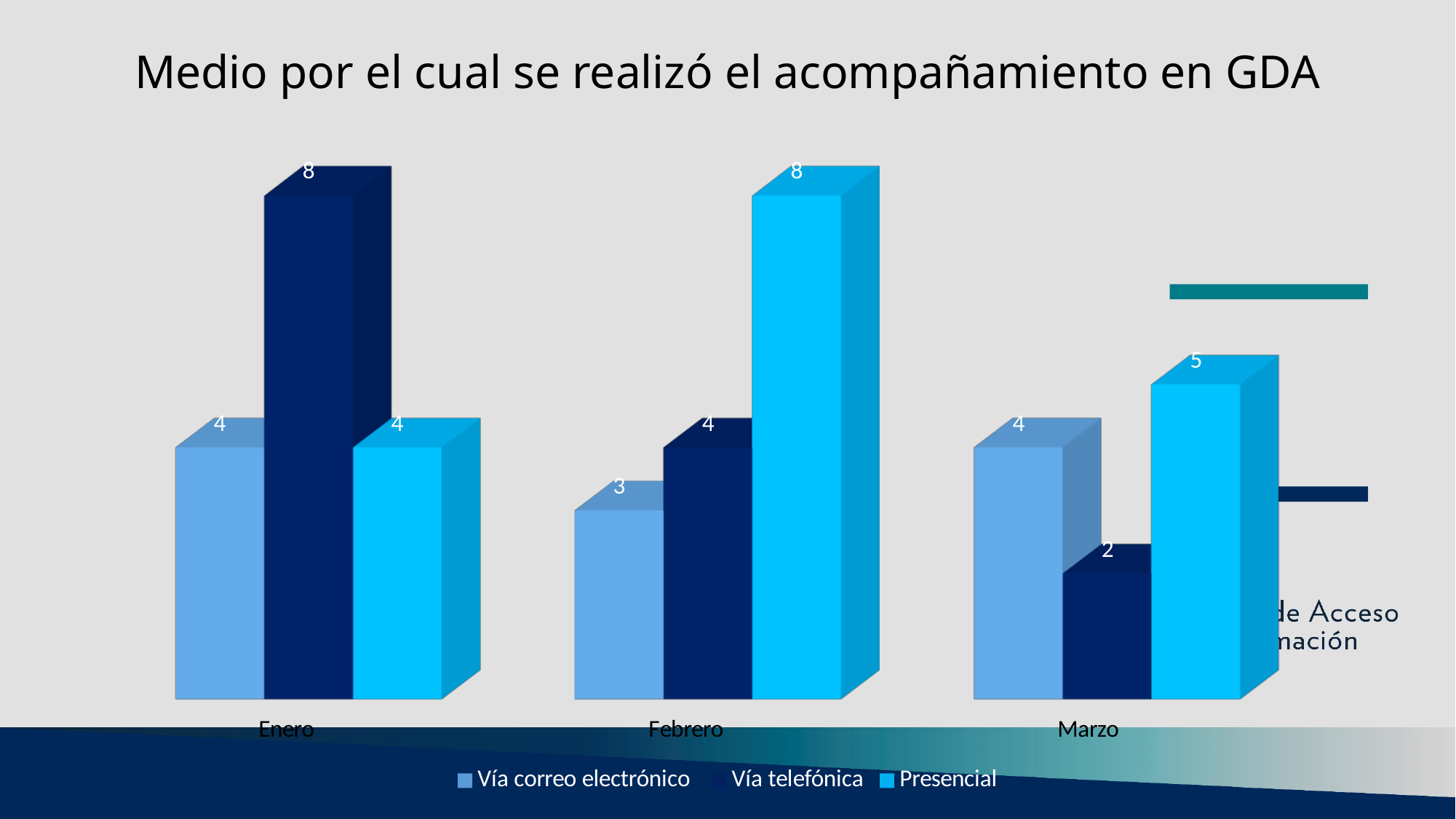
What is the value for Presencial in Febrero? 8 Which is larger in Marzo: Vía correo electrónico or Presencial? Presencial How many categories are shown on the x axis? 3 What is the value for Presencial in Marzo? 5 What is the value for Vía correo electrónico in Febrero? 3 What type of chart is shown on the slide? Bar chart Which series has the highest value in Enero? Vía telefónica What is the value for Vía telefónica in Enero? 8 How many series does the legend list? 3 What is the difference between the Presencial value and the Vía telefónica value in Febrero? 4 What is the value for Vía telefónica in Marzo? 2 Which series has the lowest value in Marzo? Vía telefónica